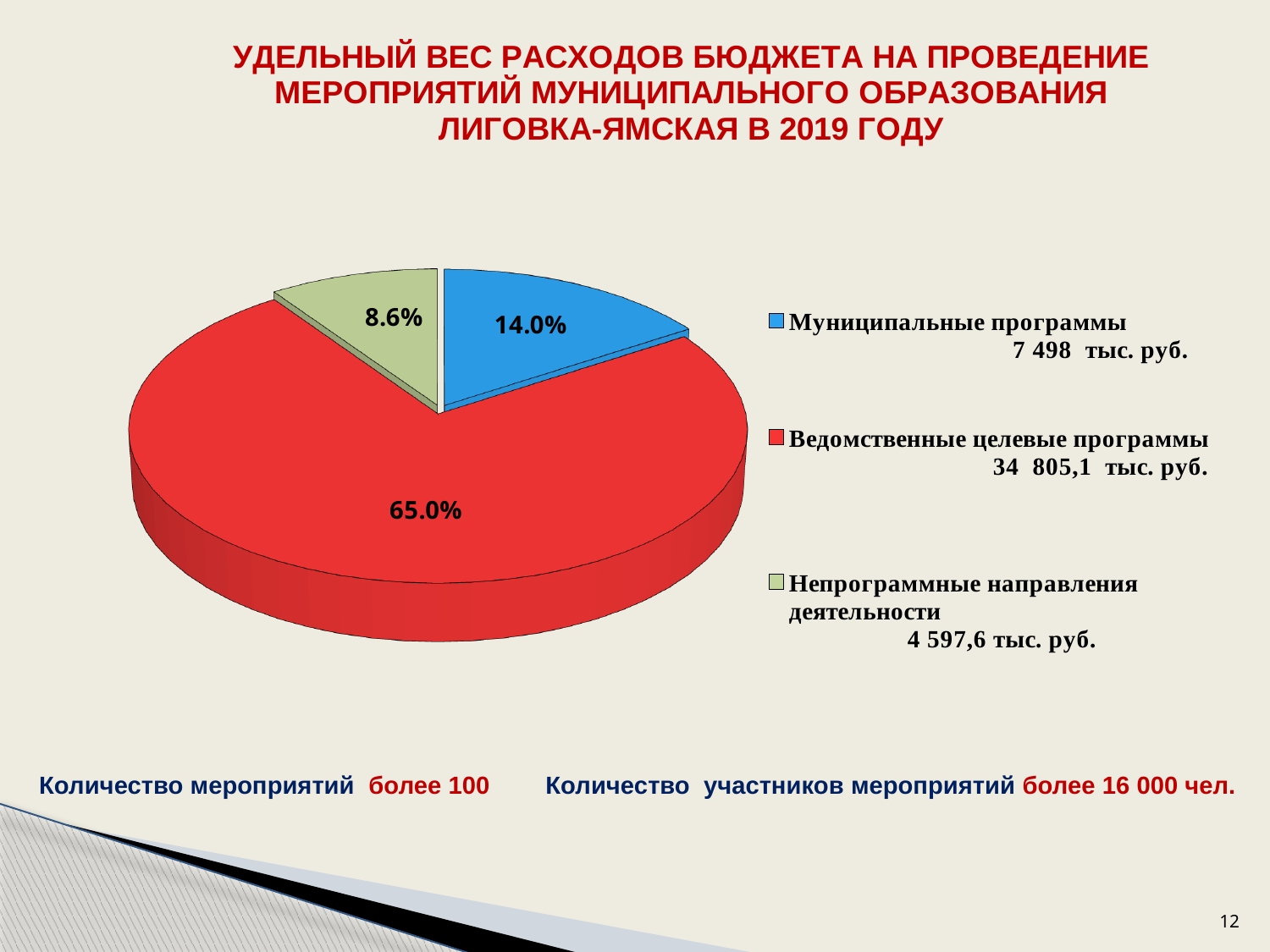
What amount in тыс. руб. is given in the legend for Ведомственные целевые программы? 34 805,1 тыс. руб. What amount in тыс. руб. is given in the legend for Муниципальные программы? 7 498 тыс. руб. What percentage is shown for the Непрограммные направления деятельности slice? 8.6% Which slice is larger: Муниципальные программы or Непрограммные направления деятельности? Муниципальные программы What percentage is shown for the Ведомственные целевые программы slice? 65.0% What colour is the Ведомственные целевые программы slice? red Which category has the smallest share of the pie? Непрограммные направления деятельности How many entries does the legend list? 3 Which category has the largest share of the pie? Ведомственные целевые программы What percentage is shown for the Муниципальные программы slice? 14.0% How many slices does the pie chart have? 3 What type of chart is shown on the slide? pie chart